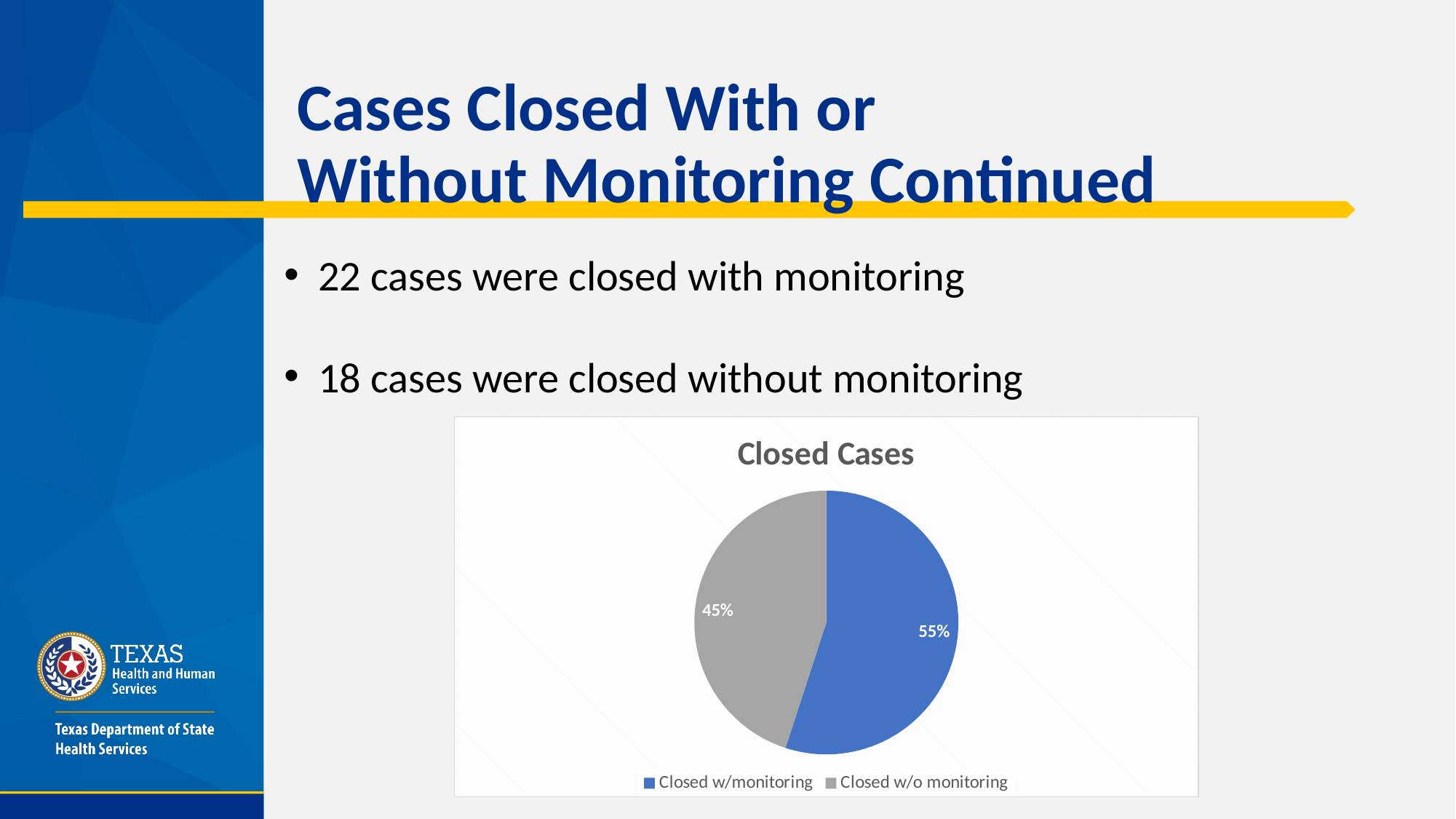
What is the difference in percentage points between the Closed w/monitoring and Closed w/o monitoring slices? 10% What share of the pie is labelled Closed w/o monitoring? 45% What kind of chart is shown on the slide? pie chart Which slice of the pie is the smallest? Closed w/o monitoring What colour is the Closed w/o monitoring slice? grey How many entries does the legend list? 2 What is the title of the chart? Closed Cases What share of the pie is labelled Closed w/monitoring? 55% Which is larger, the Closed w/monitoring slice or the Closed w/o monitoring slice? Closed w/monitoring How many slices does the pie chart have? 2 Which slice of the pie is the largest? Closed w/monitoring